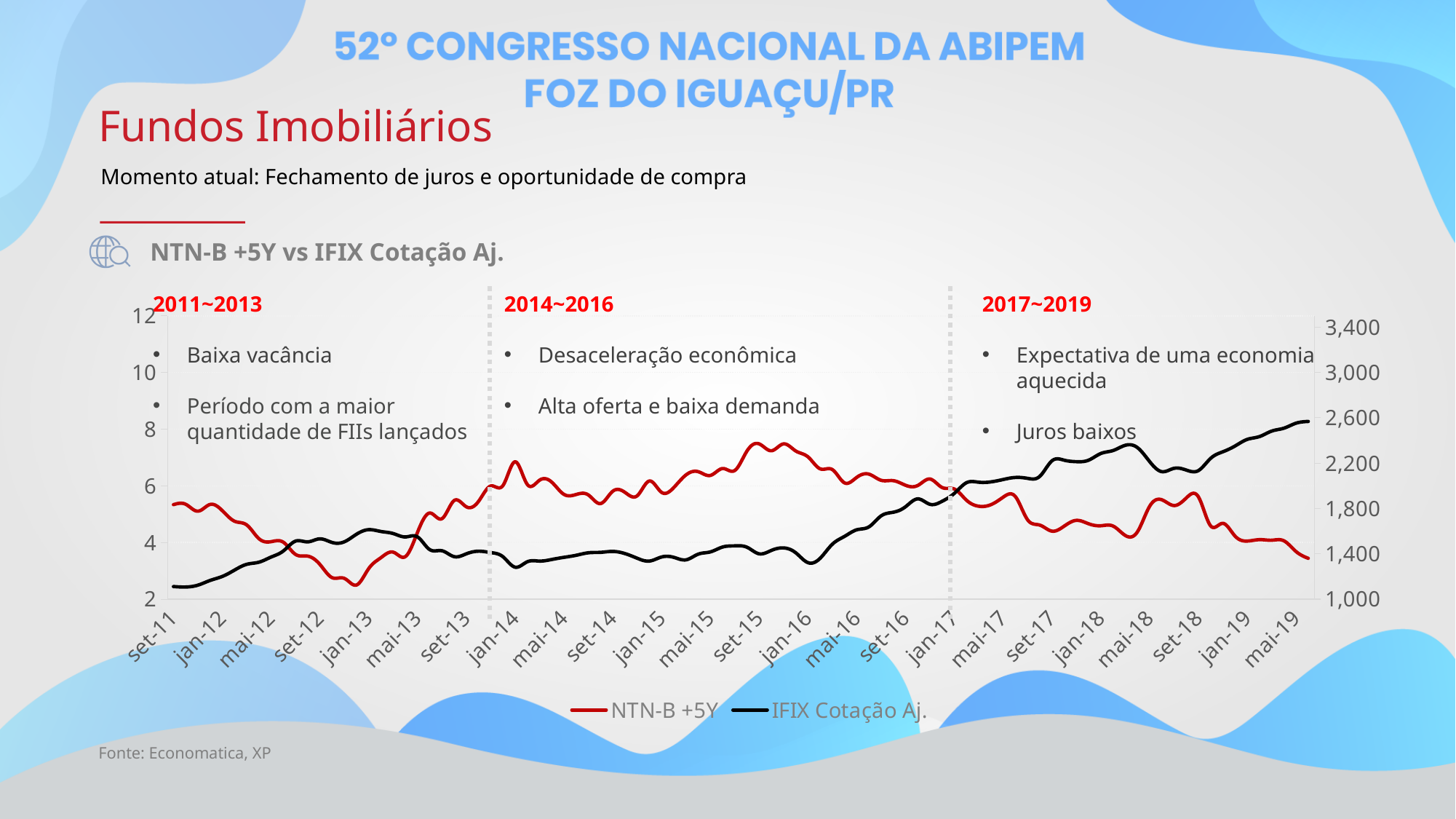
What is the title of the chart? NTN-B +5Y vs IFIX Cotação Aj. Does the NTN-B +5Y line rise or fall overall from set-15 to mai-19? fall How many date labels are shown on the x axis of the chart? 24 Is the value of IFIX Cotação Aj. at jan-16 greater or less than 1,800? less Is the value of NTN-B +5Y at set-15 greater or less than 6? greater Does the IFIX Cotação Aj. line rise or fall overall from set-11 to mai-19? rise What colour is the NTN-B +5Y line in the chart? red What kind of chart is shown on the slide? line chart Is the value of NTN-B +5Y at jan-13 greater or less than 4? less How many series does the chart legend list? 2